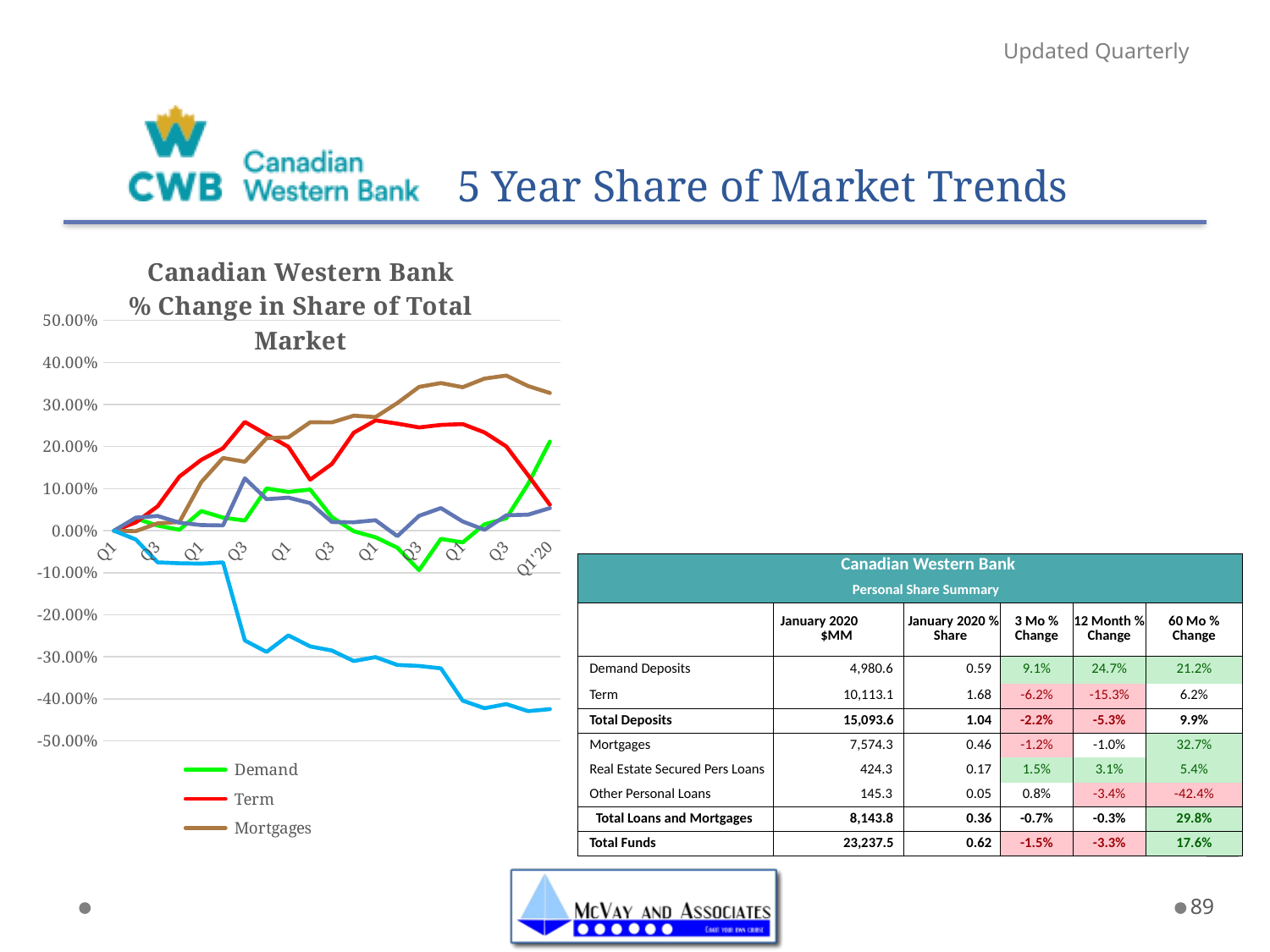
What kind of chart is shown on the slide? Line chart What is the title of the chart? Canadian Western Bank % Change in Share of Total Market At Q1'20, is the value for Term greater or less than 10.00%? less Which legend series has the lowest value at Q1'20? Term Which legend series has the highest value at Q1'20? Mortgages How many series does the chart's legend list? 3 At Q1'20, is the value for Mortgages greater or less than 20.00%? greater At Q1'20, is the value for Demand greater or less than 10.00%? greater At Q1'20, which is larger, the value for Mortgages or the value for Term? Mortgages Which series in the legend is drawn in red? Term Does the Mortgages series overall rise or fall from the first point to Q1'20? Rise What is the highest value shown on the chart's vertical axis? 50.00%